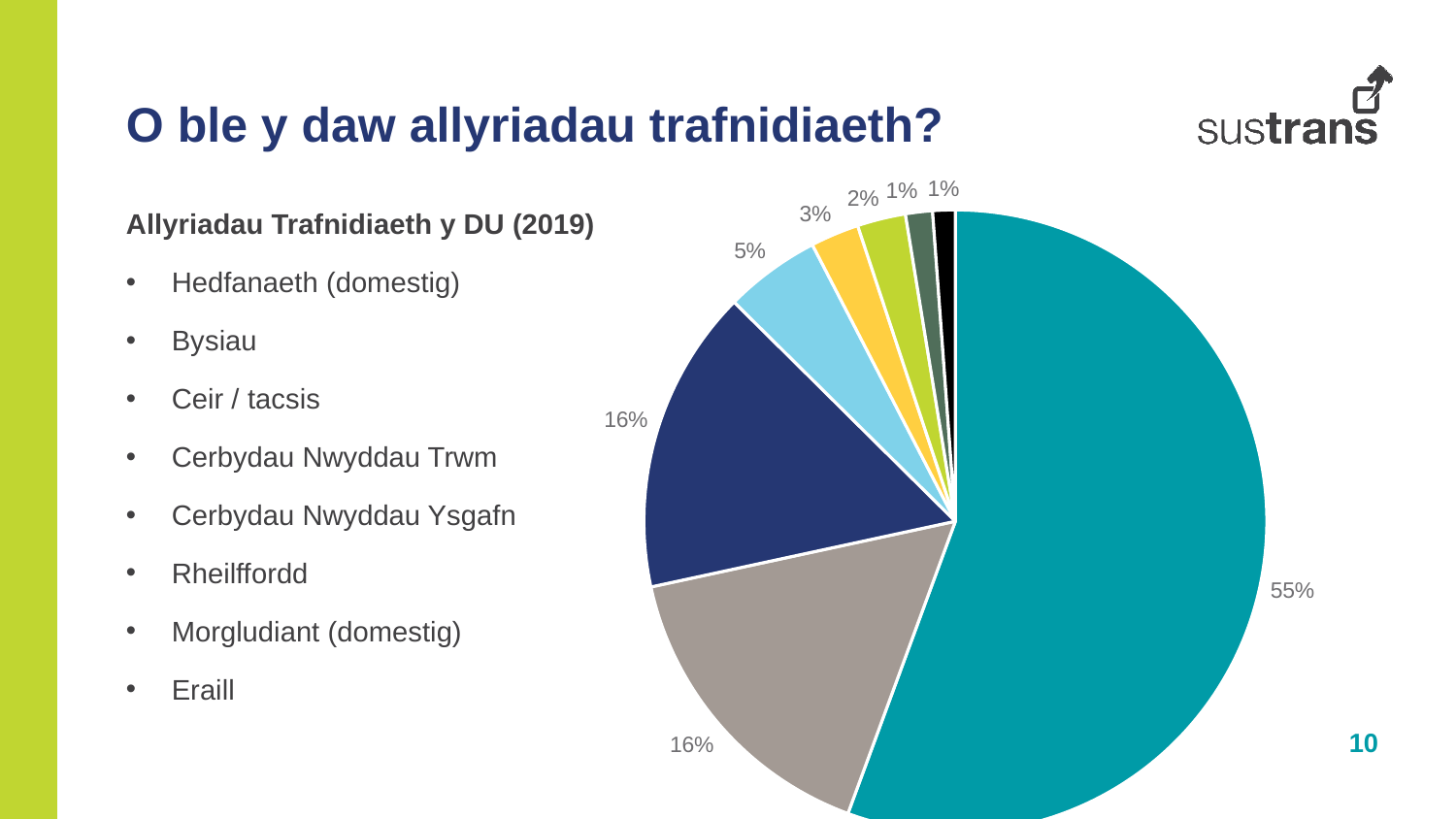
Does the largest slice of the pie chart account for more or less than half of the total? More How many slices does the pie chart have? 8 What colour is the largest slice of the pie chart? Teal How many slices in the pie chart are labelled 16%? 2 How many slices in the pie chart are labelled 1%? 2 What is the value of the largest slice in the pie chart? 55% What is the combined share of the two slices labelled 16%? 32% What kind of chart is shown on the slide? Pie chart What is the value of the smallest slice in the pie chart? 1% Which year do the UK transport emissions on the slide refer to? 2019 What is the difference in percentage points between the largest slice (55%) and a 16% slice? 39 percentage points What is the difference in percentage points between the 5% slice and the 3% slice? 2 percentage points